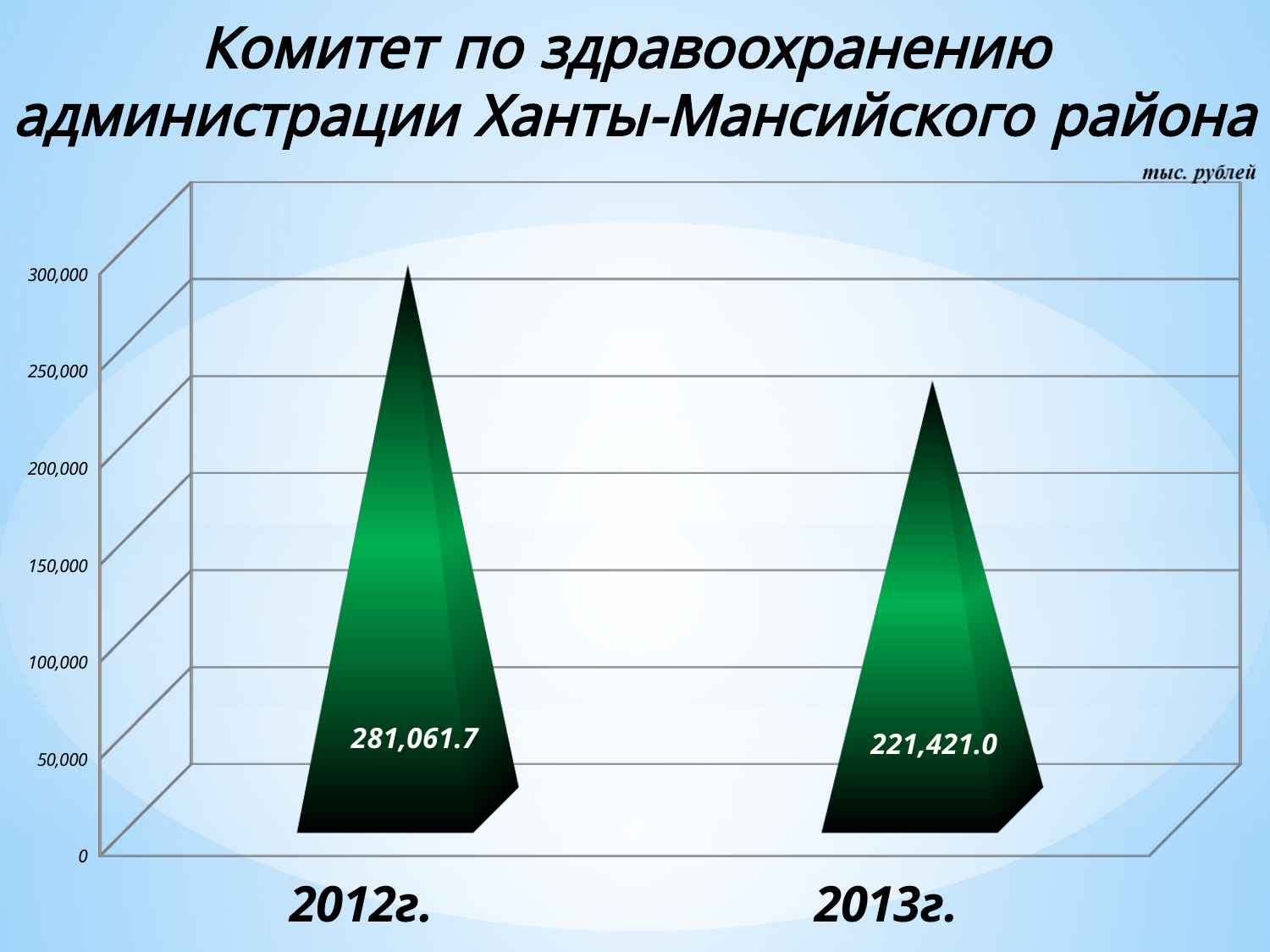
Is the value for 2013г. greater or less than 250,000? less What is the value for 2013г.? 221,421.0 How many categories (years) are shown in the chart? 2 What unit is indicated above the chart? тыс. рублей Is the value for 2012г. greater or less than 250,000? greater Which year has the higher value? 2012г. What kind of chart is shown on the slide? bar chart What is the difference between the 2012г. and 2013г. values? 59,640.7 What is the value for 2012г.? 281,061.7 Do the values rise or fall from 2012г. to 2013г.? fall Is the value for 2012г. larger or smaller than the value for 2013г.? larger Which year has the lower value? 2013г.